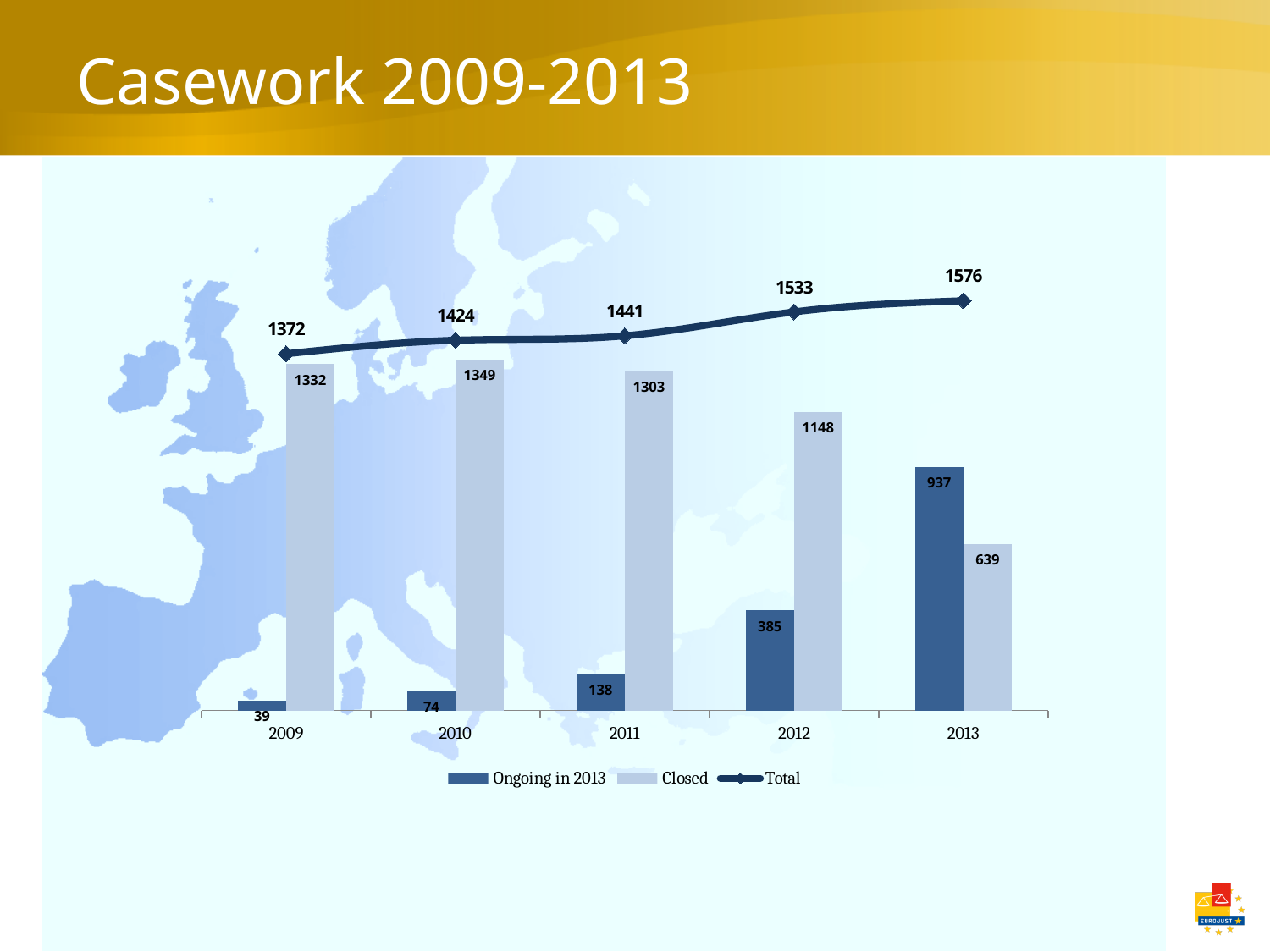
What is the title of the slide? Casework 2009-2013 How many years are shown on the x axis? 5 How many series does the legend list? 3 Which year has the lowest Ongoing in 2013 value? 2009 What is the difference between the Closed values for 2009 and 2013? 693 What is the value of Ongoing in 2013 for the year 2012? 385 Which is larger in 2013, the Ongoing in 2013 value or the Closed value? Ongoing in 2013 What is the Total value for 2013? 1576 What kind of chart is this? Combined bar and line chart What is the Closed value for 2010? 1349 Does the Total series rise or fall from 2009 to 2013? Rise Which year has the highest Closed value? 2010